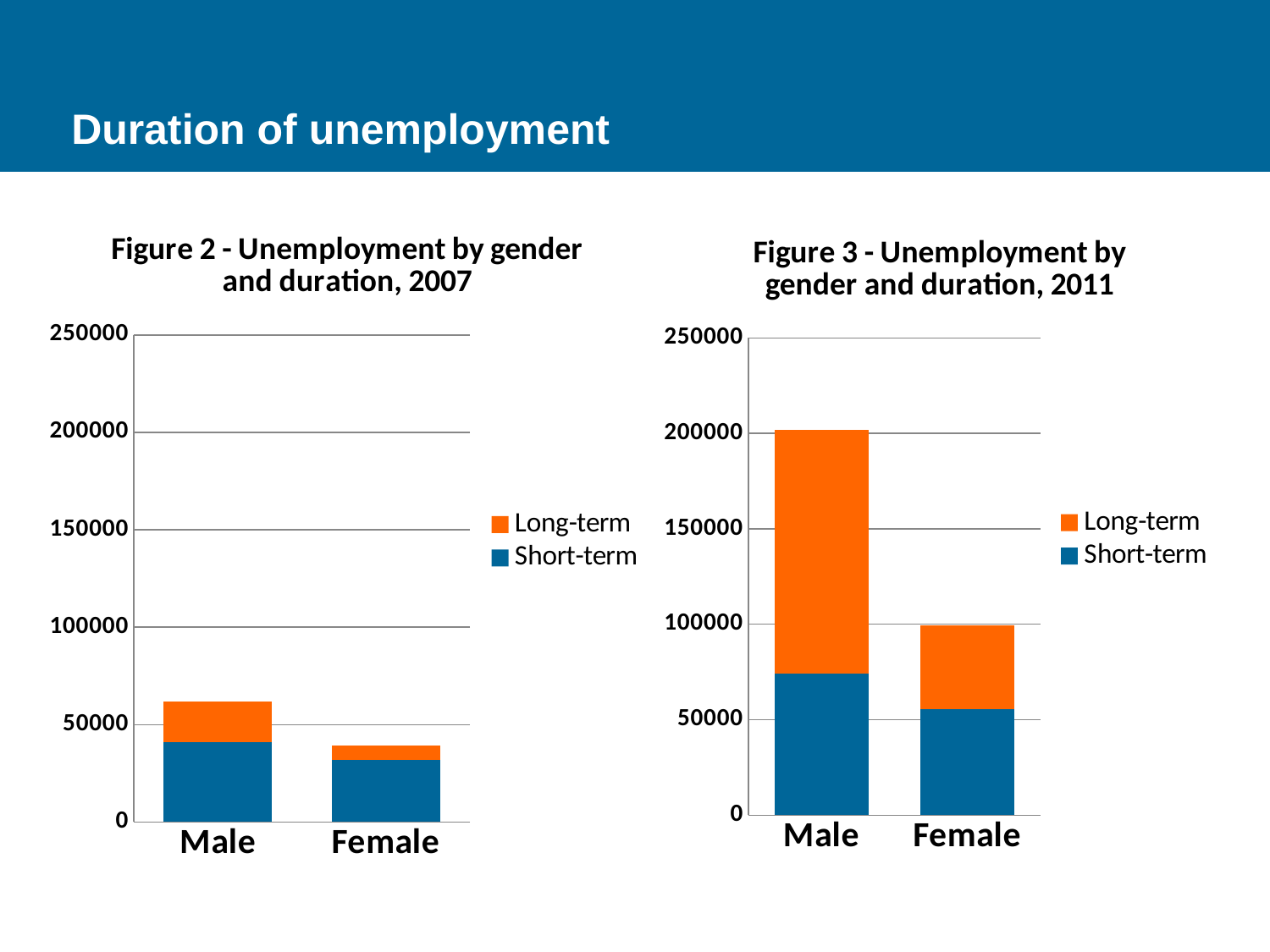
In Figure 2 - Unemployment by gender and duration, 2007, which category has the highest total bar? Male What kind of chart is Figure 2 - Unemployment by gender and duration, 2007? Stacked bar chart In Figure 2 - Unemployment by gender and duration, 2007, is the total bar for Male greater or less than 50000? greater In Figure 3 - Unemployment by gender and duration, 2011, is the Short-term value for Male greater or less than 50000? greater In Figure 3 - Unemployment by gender and duration, 2011, how many categories are shown on the x axis? 2 In Figure 3 - Unemployment by gender and duration, 2011, is the total bar for Male greater or less than 150000? greater In Figure 2 - Unemployment by gender and duration, 2007, which is larger for Female: the Long-term segment or the Short-term segment? Short-term In Figure 3 - Unemployment by gender and duration, 2011, which is larger for Male: the Long-term segment or the Short-term segment? Long-term How many series does the legend list in Figure 2 - Unemployment by gender and duration, 2007? 2 In Figure 3 - Unemployment by gender and duration, 2011, which colour represents the Long-term series? Orange In Figure 3 - Unemployment by gender and duration, 2011, which category has the lowest total bar? Female